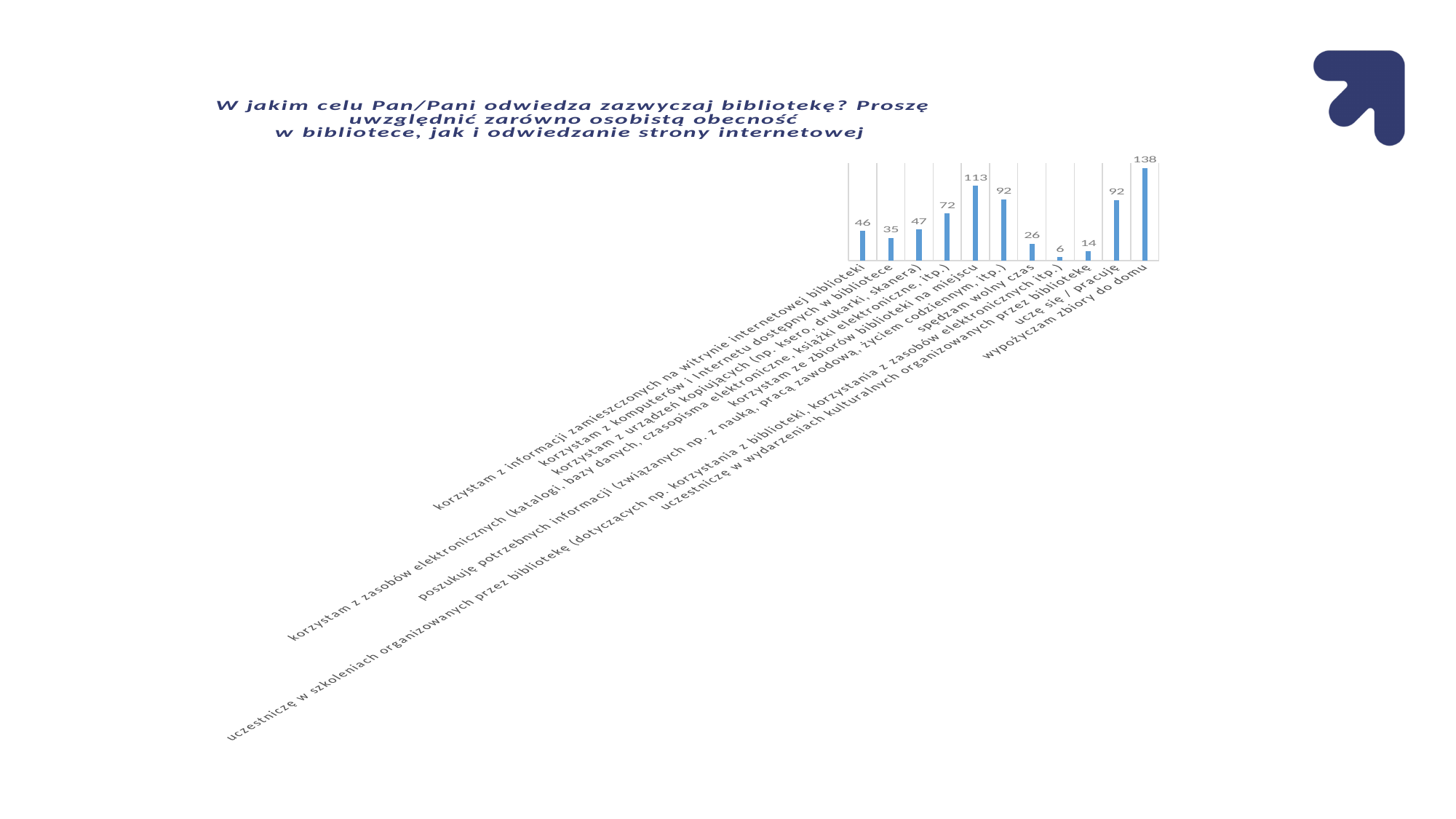
What is the value for "uczę się / pracuję"? 92 What is the difference between the values for "uczestniczę w wydarzeniach kulturalnych organizowanych przez bibliotekę" and "uczestniczę w szkoleniach organizowanych przez bibliotekę"? 8 What is the difference between the values for "wypożyczam zbiory do domu" and "korzystam ze zbiorów biblioteki na miejscu"? 25 What is the value for "korzystam z komputerów i Internetu dostępnych w bibliotece"? 35 What type of chart is shown on the slide? bar chart What is the value for "spędzam wolny czas"? 26 Which is larger: the value for "korzystam z urządzeń kopiujących" or the value for "korzystam z informacji zamieszczonych na witrynie internetowej biblioteki"? korzystam z urządzeń kopiujących What is the value for "korzystam ze zbiorów biblioteki na miejscu"? 113 Which category has the lowest value? uczestniczę w szkoleniach organizowanych przez bibliotekę How many categories are plotted in the chart? 11 Which category has the highest value? wypożyczam zbiory do domu What is the value for "wypożyczam zbiory do domu"? 138